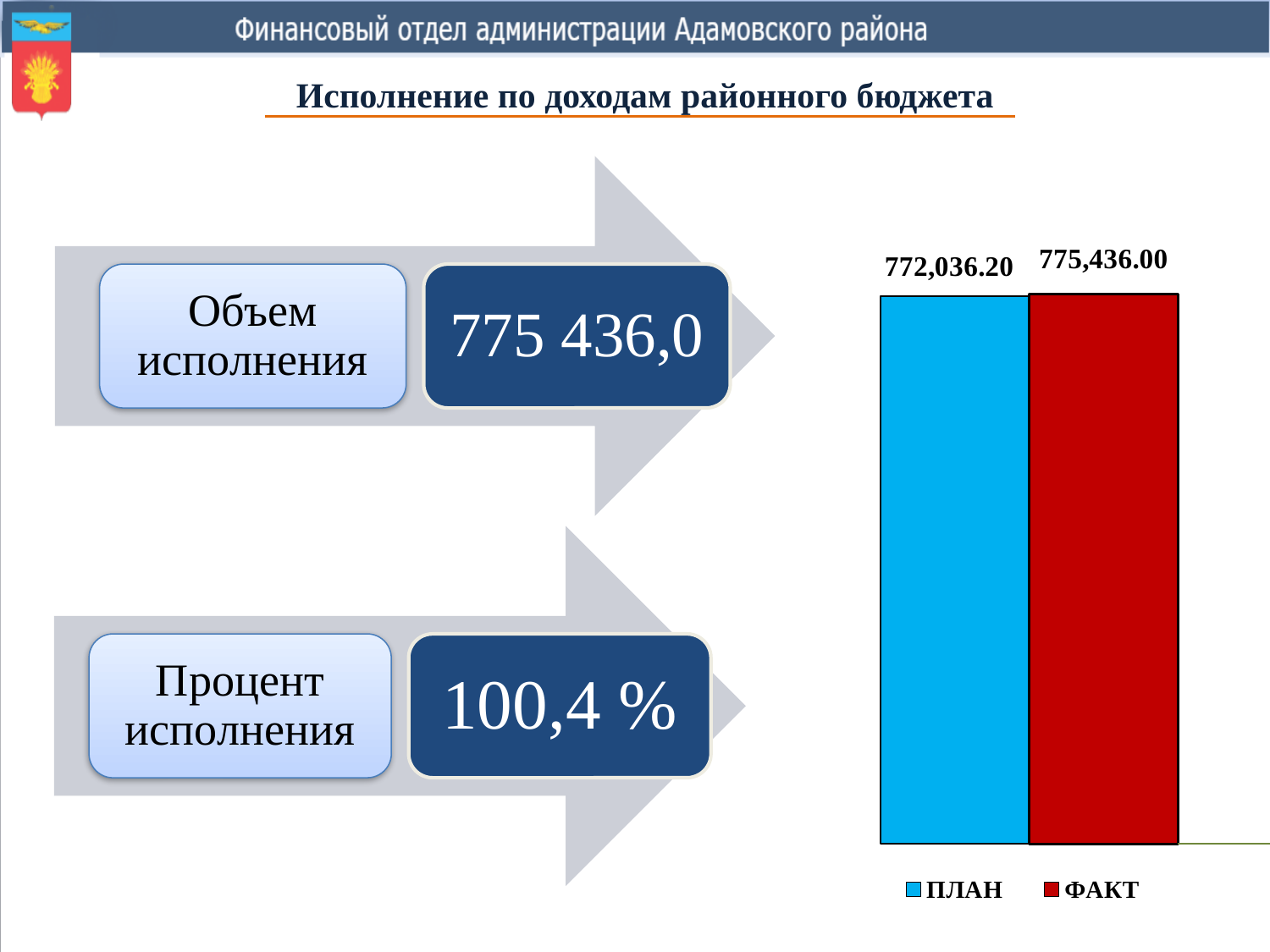
Which bar has the higher value, ПЛАН or ФАКТ? ФАКТ Which series has the lowest value in the chart? ПЛАН What colour is the ПЛАН bar? Light blue What is the value of the ПЛАН bar? 772,036.20 What is the difference between the ФАКТ value and the ПЛАН value? 3,399.80 How many series does the chart legend list? 2 What type of chart is shown on the slide? Bar chart What is the value of the ФАКТ bar? 775,436.00 What colour is the ФАКТ bar? Red Which series has the highest value in the chart? ФАКТ How many bars are plotted in the chart? 2